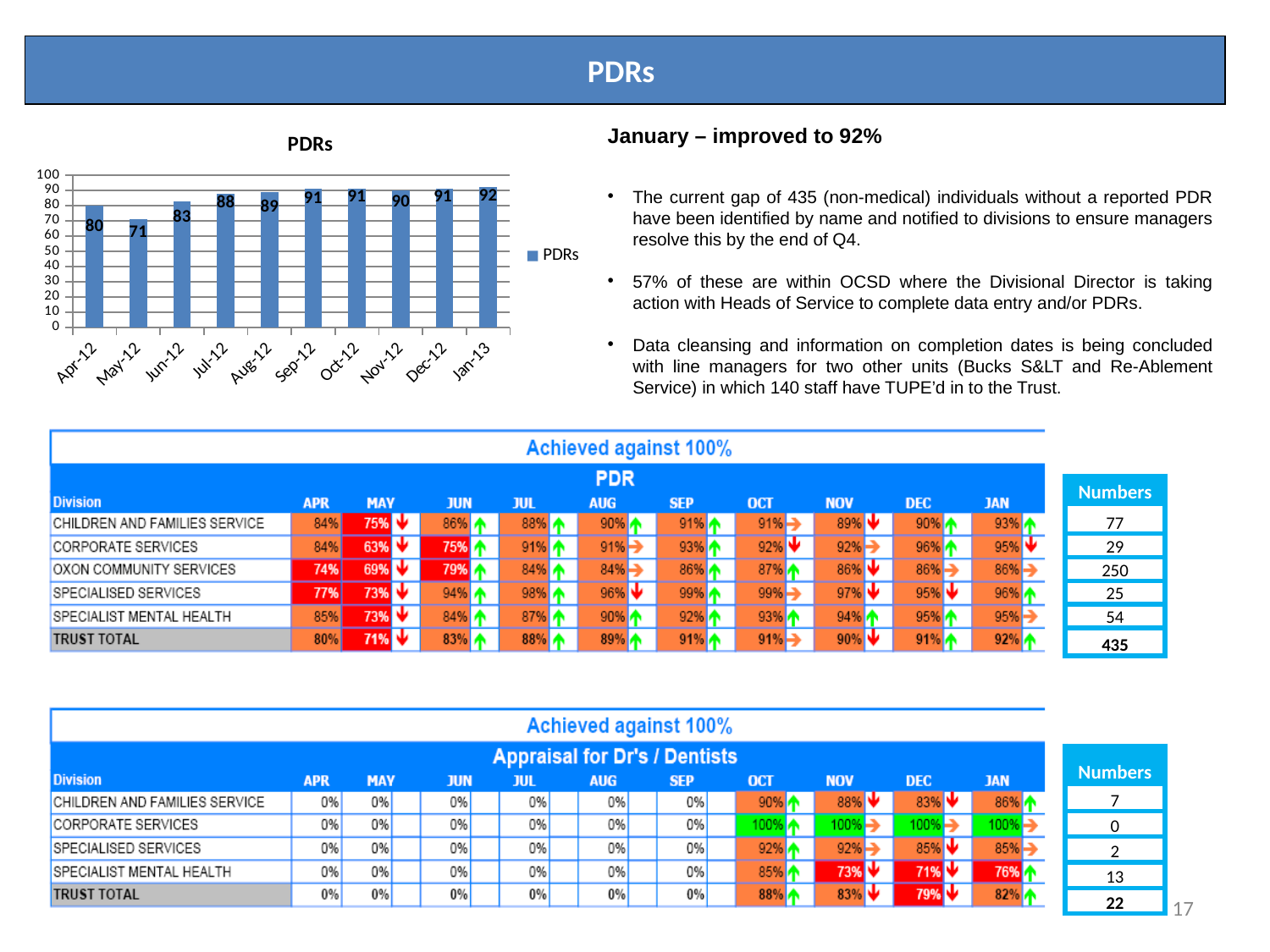
In the PDRs chart, which is larger, the value for Jun-12 or the value for Jul-12? Jul-12 Which month has the lowest value in the PDRs chart? May-12 What is the value for Nov-12 in the PDRs chart? 90 What is the difference between the Jan-13 and Apr-12 values in the PDRs chart? 12 What is the value for Apr-12 in the PDRs chart? 80 How many series does the legend of the PDRs chart list? 1 What type of chart is the PDRs chart? bar chart Do the values in the PDRs chart generally rise or fall from Apr-12 to Jan-13? rise What is the value for May-12 in the PDRs chart? 71 What is the value for Jan-13 in the PDRs chart? 92 Which month has the highest value in the PDRs chart? Jan-13 How many months are plotted in the PDRs chart? 10